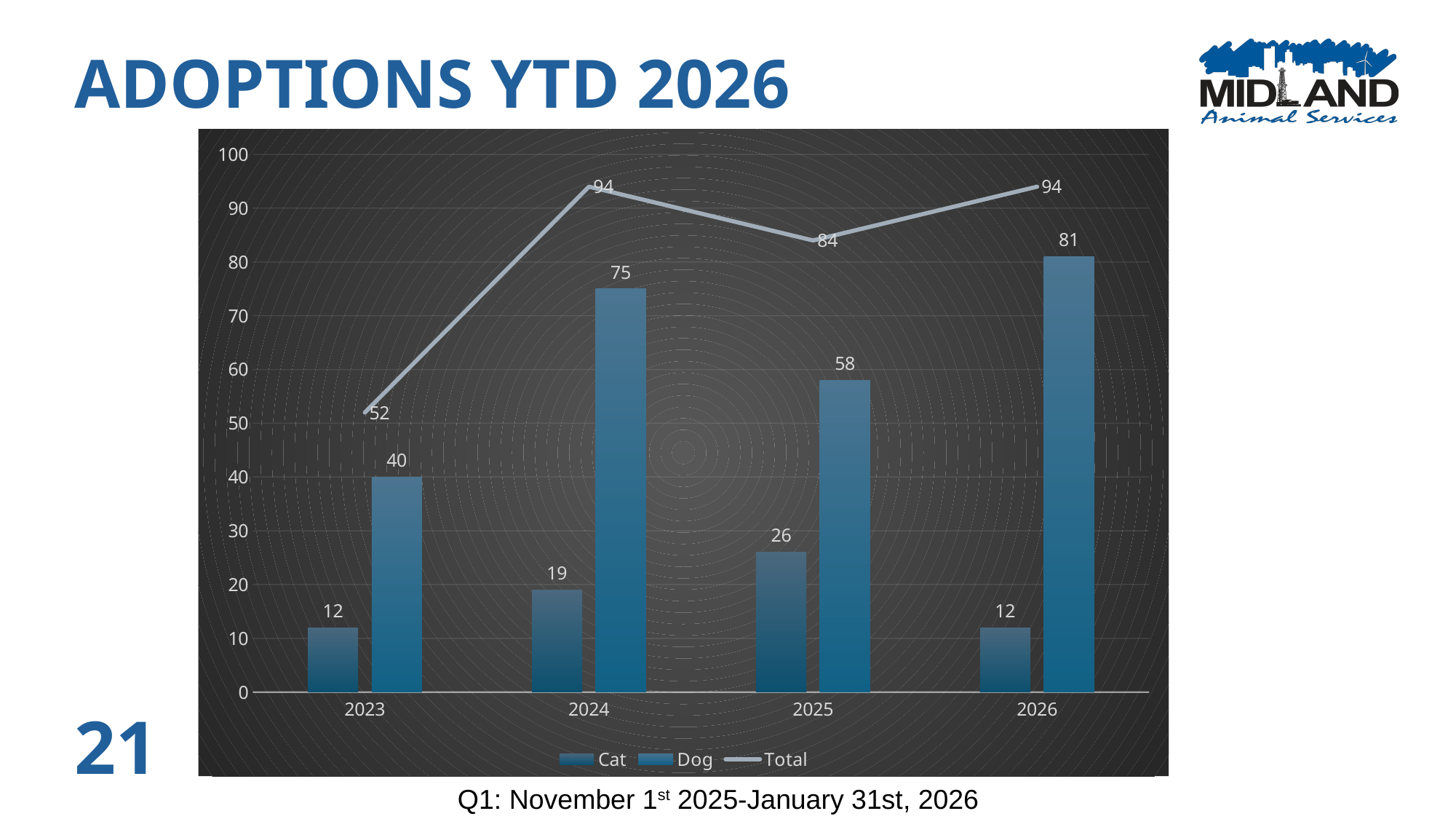
What is the title of the slide containing the chart? ADOPTIONS YTD 2026 How many years are shown on the x axis? 4 What is the difference between the Dog value and the Cat value in 2026? 69 Which year has the highest Dog value? 2026 How many series does the legend list? 3 Which year has the lowest Total value? 2023 What is the Total value for 2023? 52 What kind of chart is used for the Cat and Dog series? Bar chart What is the Dog value for 2024? 75 Does the Dog value rise or fall from 2025 to 2026? Rise What is the Cat value for 2025? 26 Which is larger, the Cat value for 2024 or the Cat value for 2025? 2025